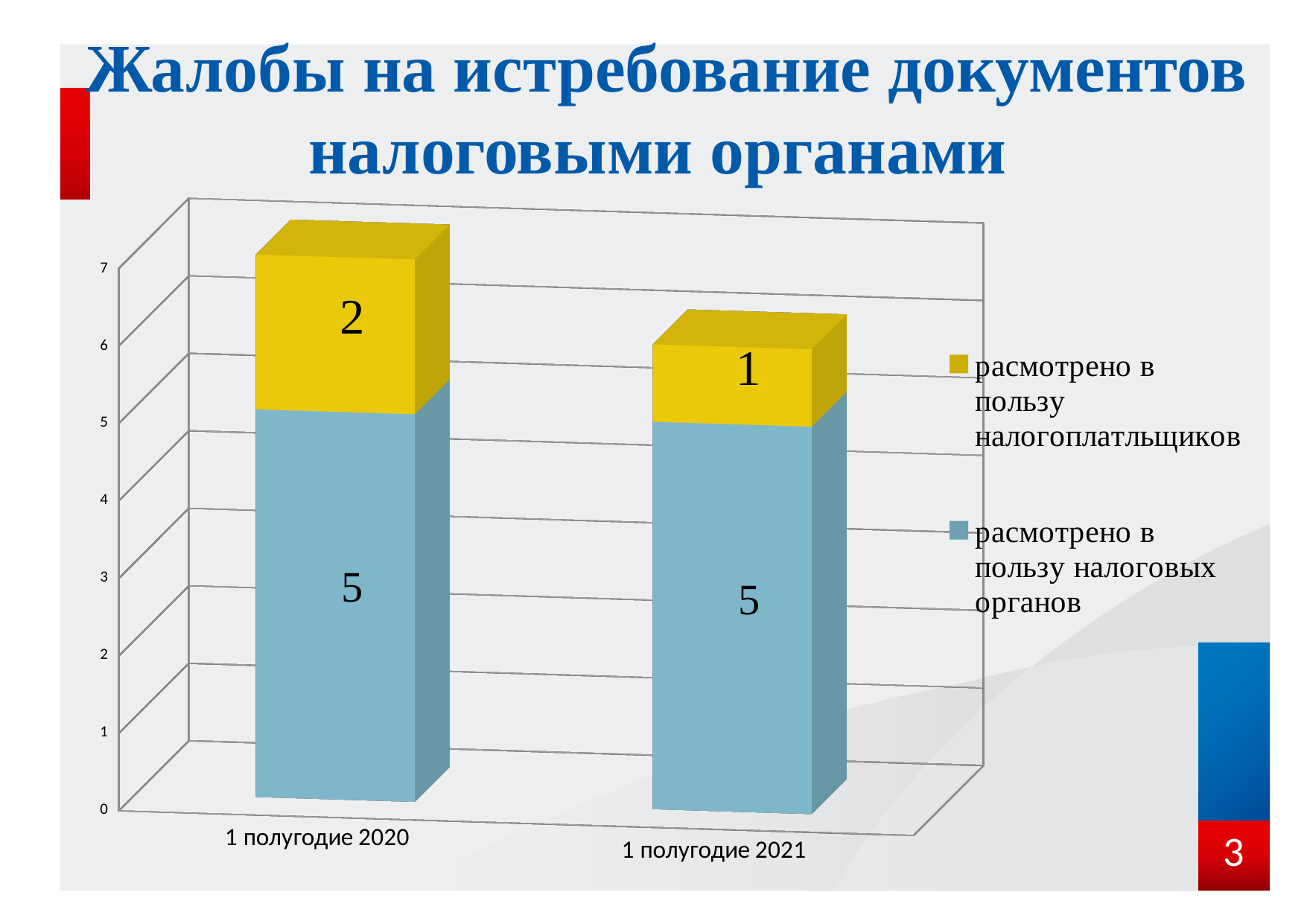
What is the value for 'рассмотрено в пользу налогоплатльщиков' in 1 полугодие 2020? 2 Which category has the higher value for 'рассмотрено в пользу налогоплатльщиков'? 1 полугодие 2020 How many categories are shown on the x axis? 2 What colour represents 'рассмотрено в пользу налоговых органов' in the chart? Blue What is the total of the stacked bar for 1 полугодие 2021? 6 Does the total for 'рассмотрено в пользу налогоплатльщиков' rise or fall from 1 полугодие 2020 to 1 полугодие 2021? Fall What type of chart is shown on the slide? Stacked bar chart How many series does the legend list? 2 What is the value for 'рассмотрено в пользу налоговых органов' in 1 полугодие 2021? 5 What is the difference between the 'рассмотрено в пользу налогоплатльщиков' values for 1 полугодие 2020 and 1 полугодие 2021? 1 What is the total of the stacked bar for 1 полугодие 2020? 7 What is the value for 'рассмотрено в пользу налогоплатльщиков' in 1 полугодие 2021? 1